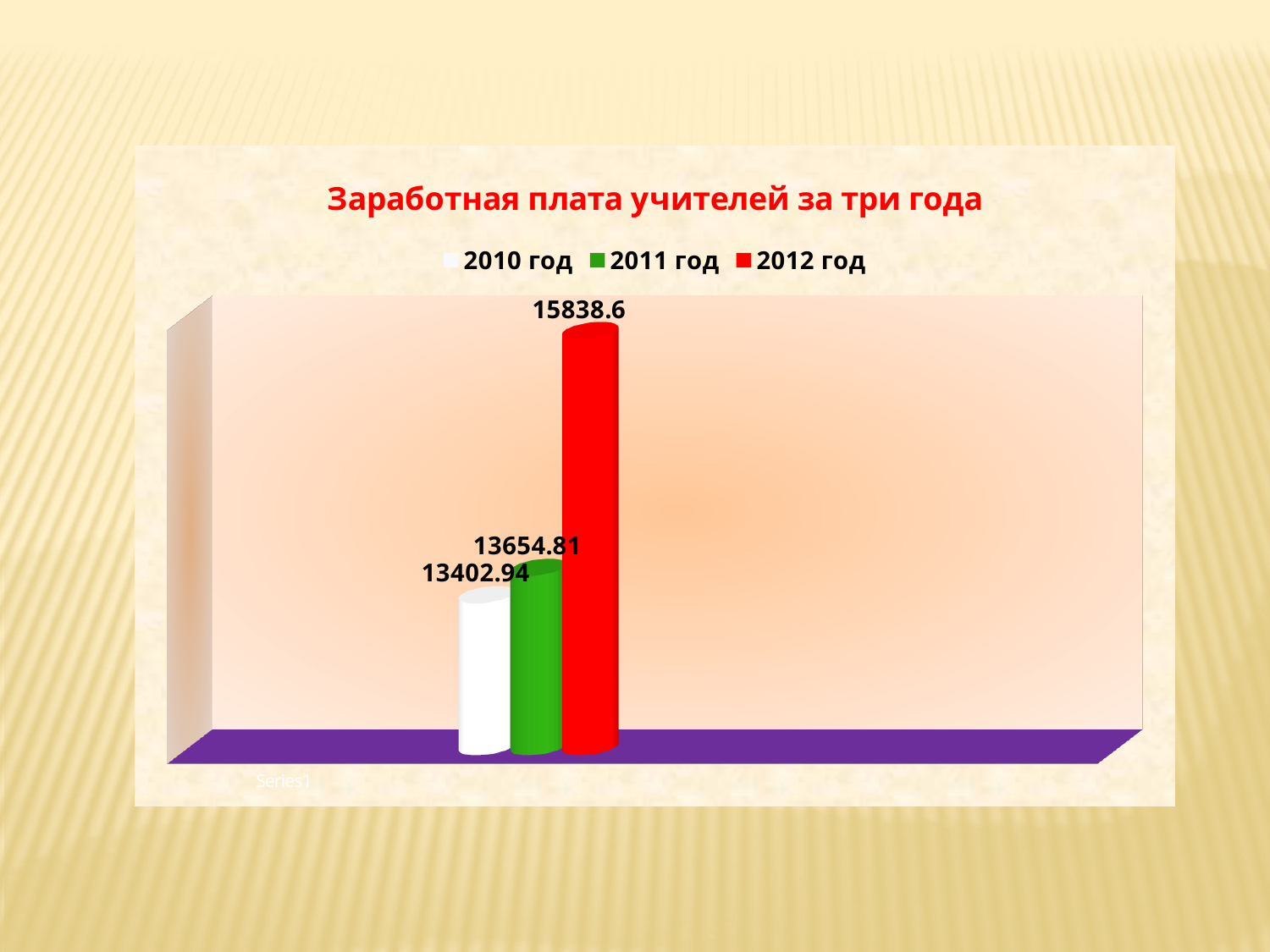
Which year has the lowest teacher salary value? 2010 год Which year has the highest teacher salary value? 2012 год What is the value for 2010 год? 13402.94 Which is larger, the value for 2011 год or the value for 2010 год? 2011 год Do the values rise or fall from 2010 год to 2012 год? Rise What kind of chart is shown on the slide? Bar chart How many series does the legend list? 3 What is the value for 2011 год? 13654.81 What is the difference between the values for 2011 год and 2010 год? 251.87 What is the title of the chart? Заработная плата учителей за три года What is the difference between the values for 2012 год and 2010 год? 2435.66 What is the value for 2012 год? 15838.6